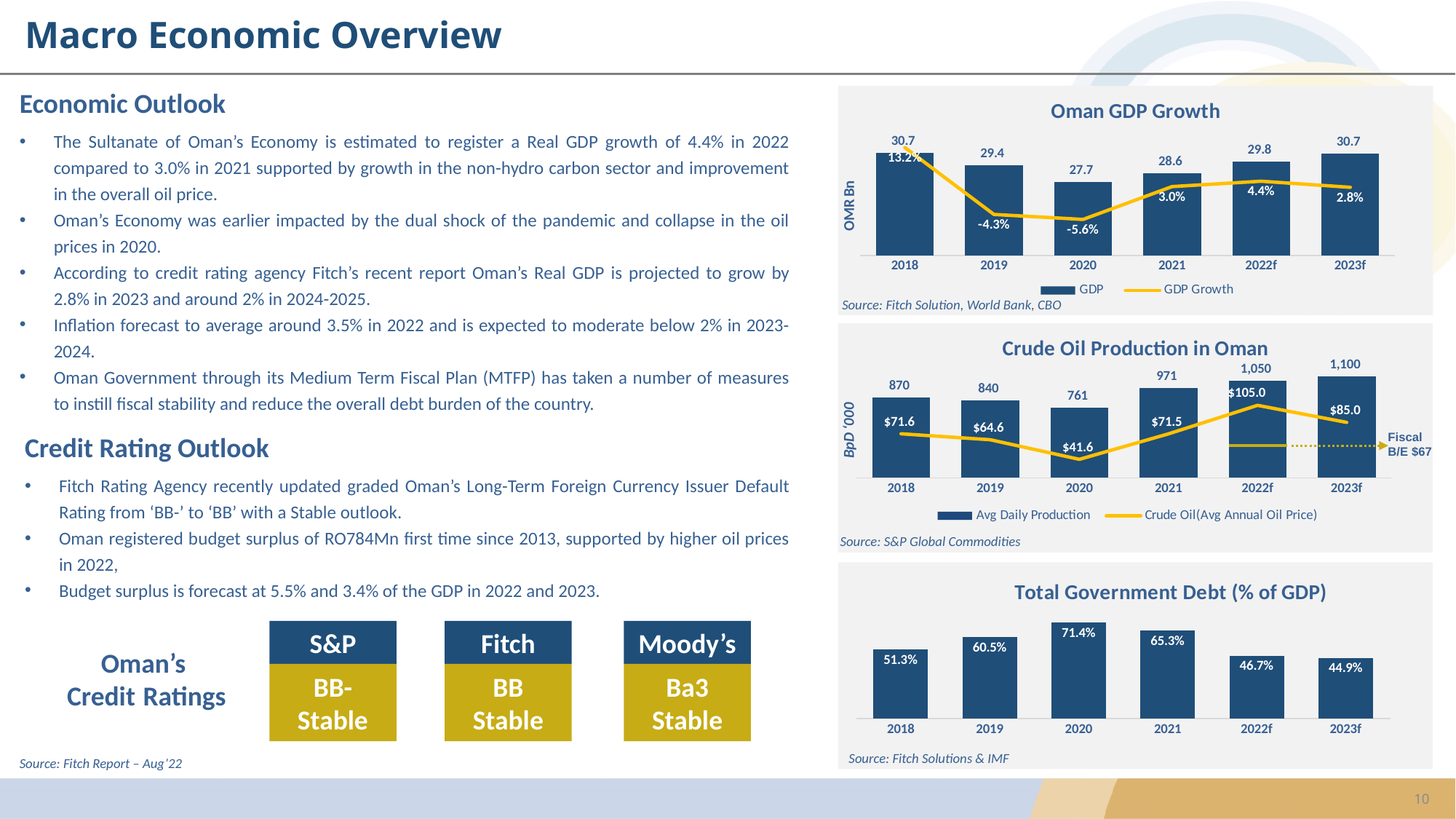
In the Oman GDP Growth chart, which year has the lowest GDP bar? 2020 In the Crude Oil Production in Oman chart, which year has the highest Avg Daily Production? 2023f In the Oman GDP Growth chart, how many series does the legend list? 2 In the Oman GDP Growth chart, what is the GDP value for 2020? 27.7 In the Crude Oil Production in Oman chart, what is the Avg Daily Production for 2021? 971 In the Total Government Debt (% of GDP) chart, what is the value for 2023f? 44.9% In the Crude Oil Production in Oman chart, what is the Crude Oil average annual price for 2020? $41.6 In the Total Government Debt (% of GDP) chart, is the value for 2019 or 2022f larger? 2019 In the Crude Oil Production in Oman chart, what is the difference in Avg Daily Production between 2023f and 2018? 230 In the Total Government Debt (% of GDP) chart, which year has the highest value? 2020 In the Total Government Debt (% of GDP) chart, how many years are shown on the x axis? 6 In the Oman GDP Growth chart, what is the GDP Growth value for 2019? -4.3%